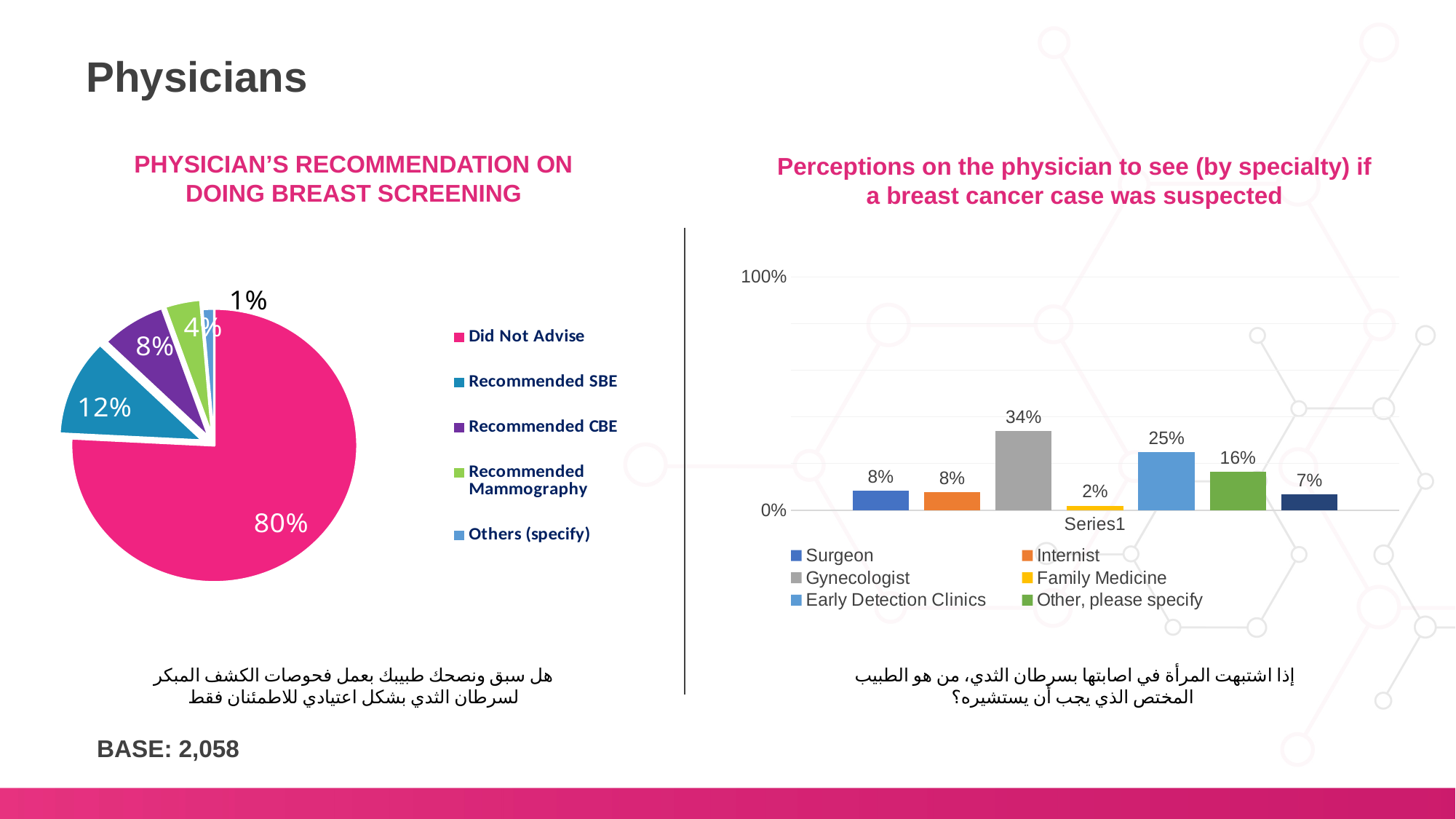
In the pie chart on the left, what percentage corresponds to Recommended SBE? 12% In the pie chart on the left, what share of physicians did not advise breast screening? 80% In the pie chart on the left, what is the difference between Recommended SBE and Recommended CBE? 4% In the chart on the right, what is the difference between Gynecologist and Early Detection Clinics? 9% In the chart on the right, what is the value for Early Detection Clinics? 25% In the pie chart on the left, how many categories does the legend list? 5 In the chart on the right, which specialty has the highest value? Gynecologist In the pie chart on the left, what percentage corresponds to Recommended Mammography? 4% What type of chart is shown on the right side of the slide? Bar chart In the pie chart on the left, which category has the smallest slice? Others (specify) In the chart on the right, which is larger, the value for Family Medicine or the value for Internist? Internist In the chart on the right, what is the value for Gynecologist? 34%